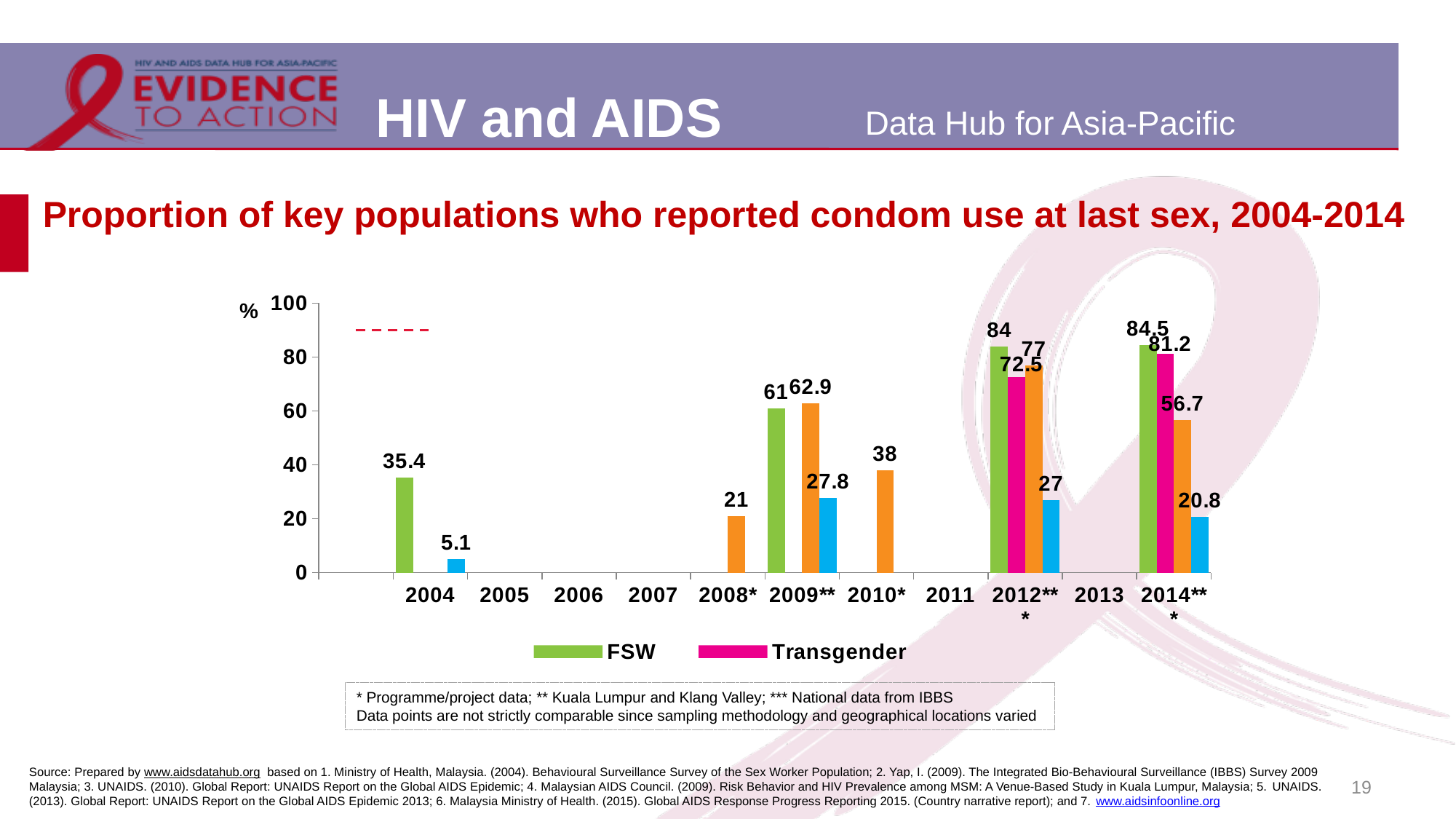
Do the FSW values rise or fall from 2004 to 2014***? rise What is the Transgender value for 2014***? 81.2 What is the FSW value for 2014***? 84.5 Which is larger in 2012***, the FSW value or the Transgender value? FSW What is the Transgender value for 2012***? 72.5 By how much did the Transgender value increase from 2012*** to 2014***? 8.7 What is the FSW value for 2004? 35.4 In which year is the FSW value highest? 2014*** How many series does the legend list? 2 What is the FSW value for 2012***? 84 What is the FSW value for 2009**? 61 What kind of chart is shown on the slide? bar chart